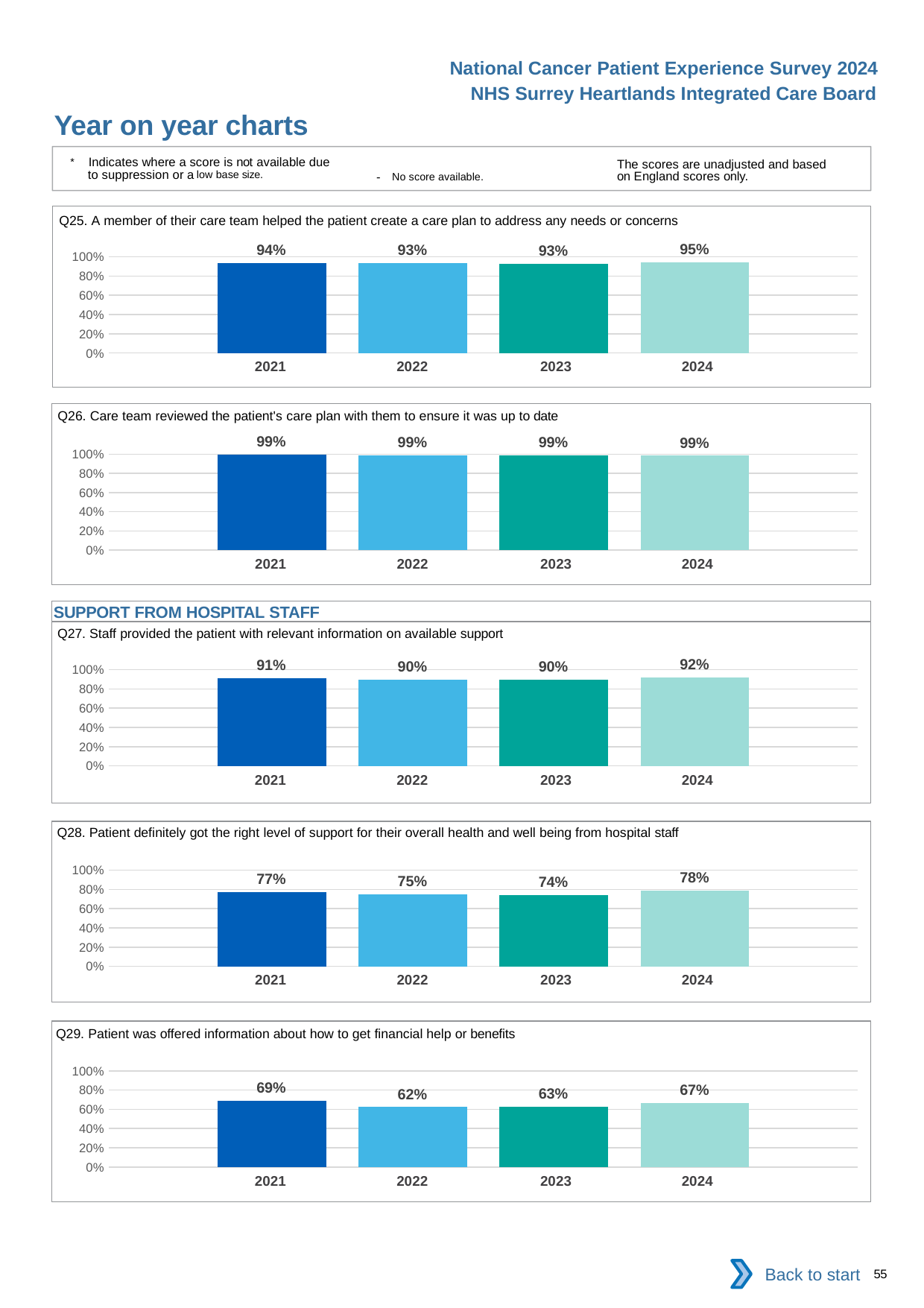
In the Q27 chart (staff provided information on available support), what is the difference between the 2024 and 2023 values? 2 percentage points In the Q27 chart (staff provided information on available support), which year has the lowest value? 2022 and 2023 (both 90%) In the Q29 chart (information about financial help or benefits), is the value for 2021 larger than the value for 2024? Yes, 2021 (69%) is larger than 2024 (67%) In the Q26 chart (care team reviewed the care plan), what is the value for 2021? 99% In the Q25 chart (care team helped create a care plan), what is the value for 2024? 95% In the Q29 chart (information about financial help or benefits), what is the difference between the 2021 and 2022 values? 7 percentage points In the Q25 chart (care team helped create a care plan), which year has the highest value? 2024 In the Q28 chart (right level of support from hospital staff), is the value for 2022 greater or less than 80%? less In the Q28 chart (right level of support from hospital staff), what is the value for 2023? 74% How many years are shown in the Q25 chart? 4 In the Q28 chart (right level of support from hospital staff), which year has the highest value? 2024 In the Q29 chart (information about financial help or benefits), which year has the lowest value? 2022